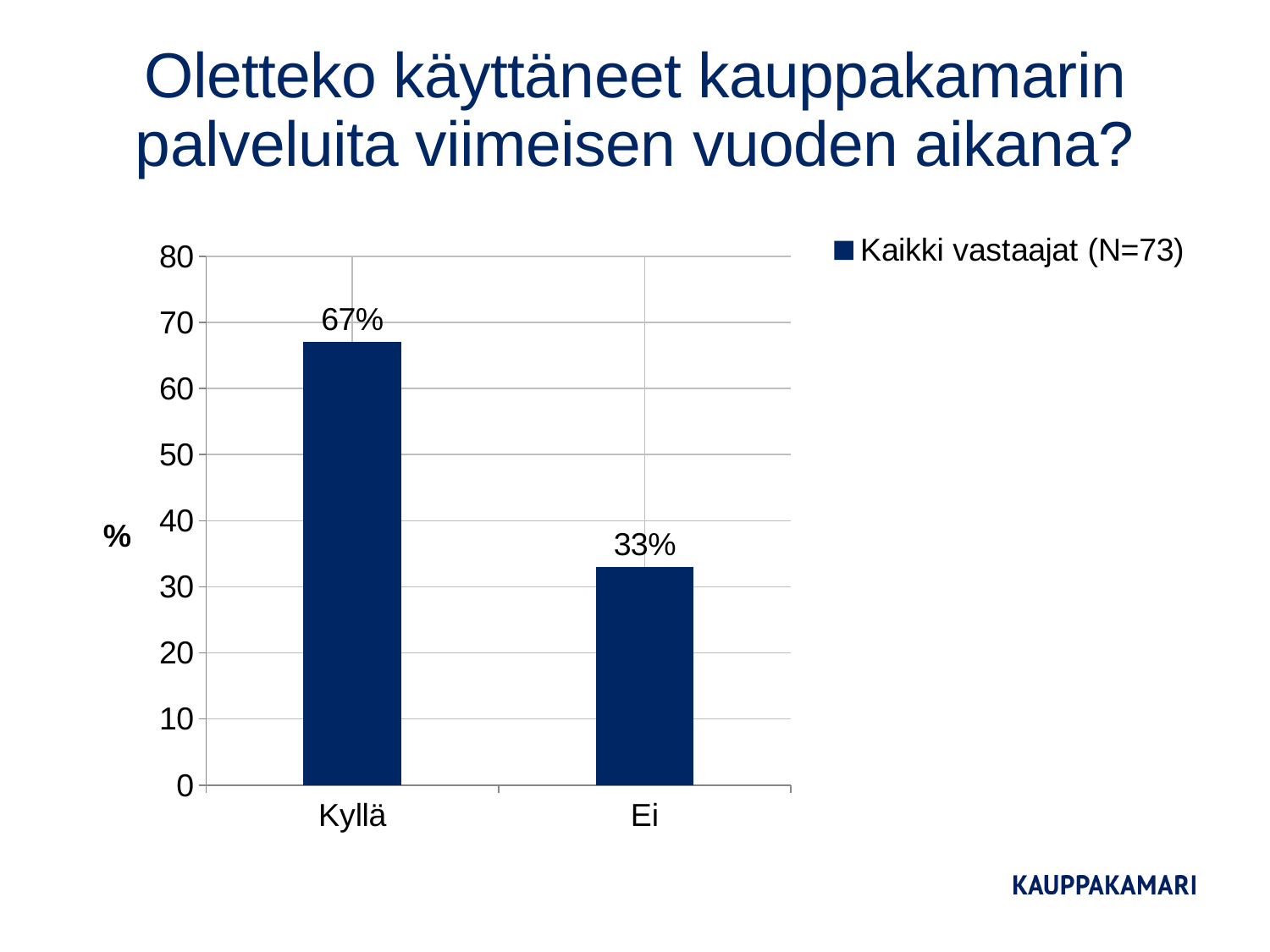
Which category has the lowest value? Ei What is the value for Ei? 33% Which is larger, the value for Kyllä or the value for Ei? Kyllä What is the difference between the values for Kyllä and Ei? 34% What kind of chart is shown on the slide? bar chart Is the value for Ei greater or less than 40? less What is the legend entry for the series shown? Kaikki vastaajat (N=73) What is the value for Kyllä? 67% How many categories are shown on the x axis? 2 How many series does the legend list? 1 Which category has the highest value? Kyllä Is the value for Kyllä greater or less than 60? greater